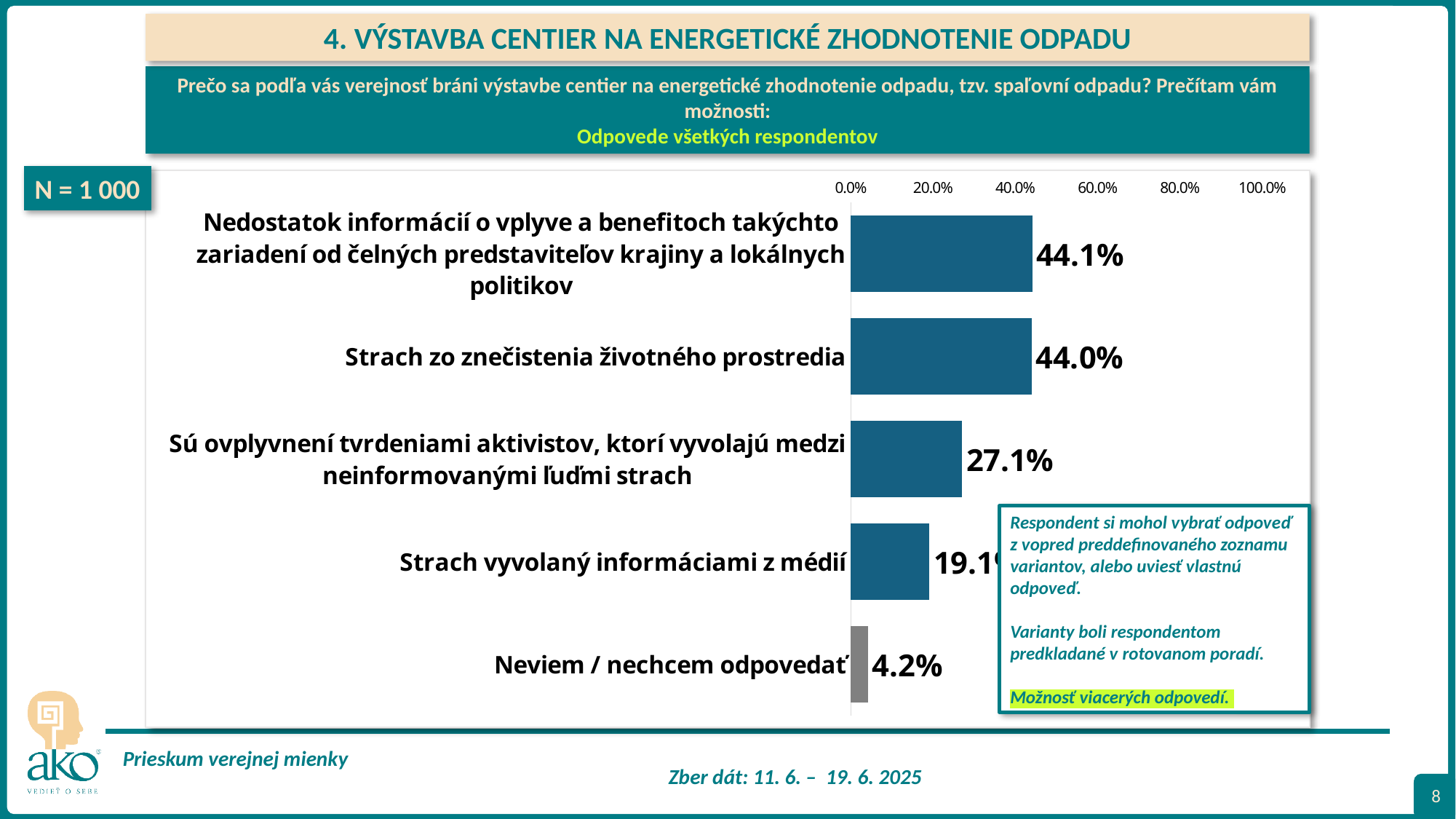
What is the difference between the values for "Strach zo znečistenia životného prostredia" and "Sú ovplyvnení tvrdeniami aktivistov, ktorí vyvolajú medzi neinformovanými ľuďmi strach"? 16.9 percentage points What sample size (N) is shown on the slide? N = 1 000 What is the value for "Strach zo znečistenia životného prostredia"? 44.0% What is the value for "Nedostatok informácií o vplyve a benefitoch takýchto zariadení od čelných predstaviteľov krajiny a lokálnych politikov"? 44.1% What kind of chart is shown on the slide? bar chart What is the value for "Sú ovplyvnení tvrdeniami aktivistov, ktorí vyvolajú medzi neinformovanými ľuďmi strach"? 27.1% What is the value for "Neviem / nechcem odpovedať"? 4.2% Is the value for "Strach vyvolaný informáciami z médií" greater or less than 20.0%? less Which category has the highest value? Nedostatok informácií o vplyve a benefitoch takýchto zariadení od čelných predstaviteľov krajiny a lokálnych politikov Which is larger: the value for "Sú ovplyvnení tvrdeniami aktivistov, ktorí vyvolajú medzi neinformovanými ľuďmi strach" or the value for "Strach vyvolaný informáciami z médií"? Sú ovplyvnení tvrdeniami aktivistov, ktorí vyvolajú medzi neinformovanými ľuďmi strach Which category has the lowest value? Neviem / nechcem odpovedať How many categories are shown in the chart? 5